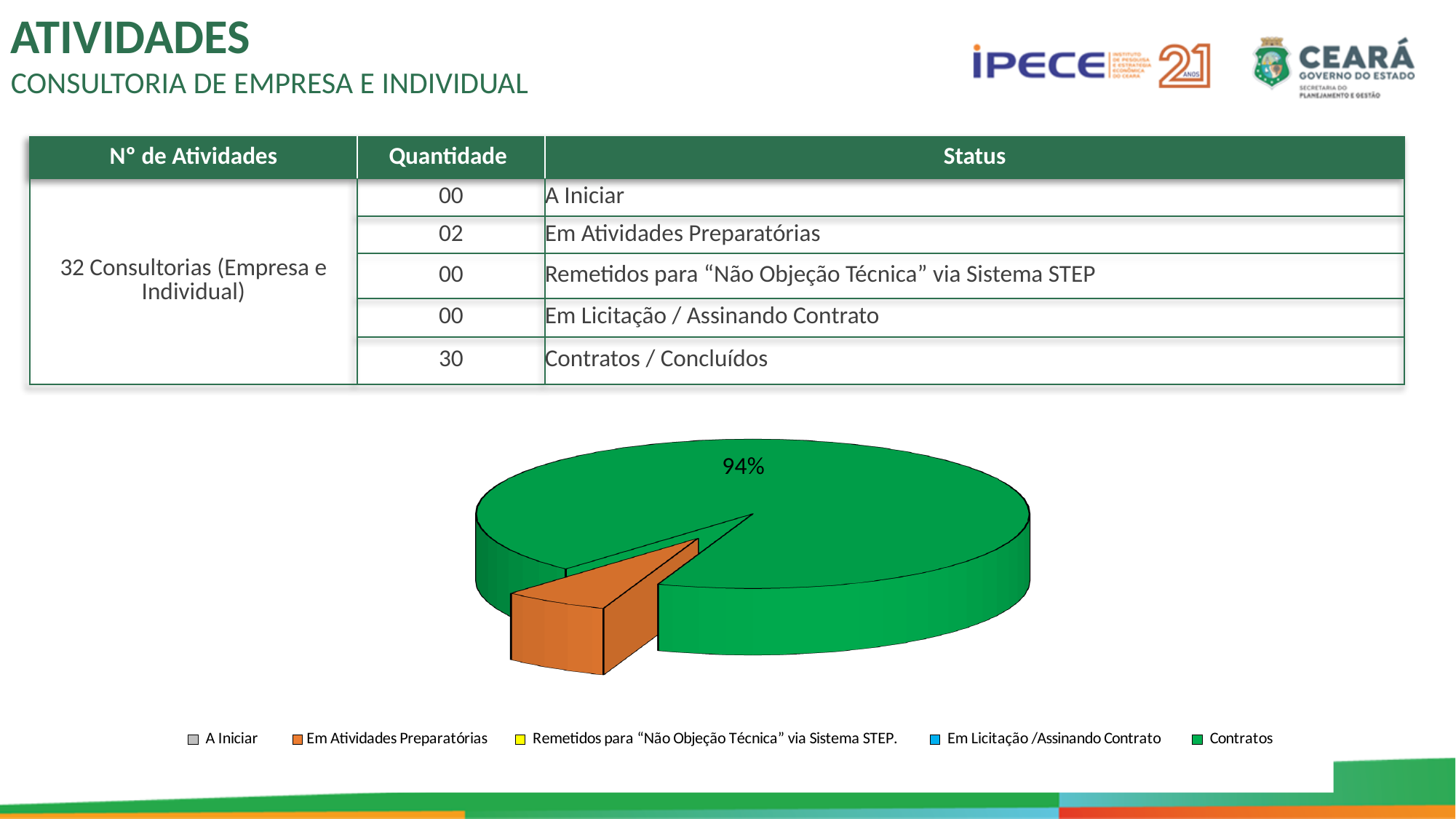
Is the share for Contratos greater or less than 50%? greater Which slice is larger, Contratos or Em Atividades Preparatórias? Contratos What percentage is printed on the Contratos slice of the pie chart? 94% Which legend category corresponds to the small pulled-out slice of the pie? Em Atividades Preparatórias What colour does the legend assign to Em Atividades Preparatórias? orange How many slices are visibly drawn in the pie chart? 2 What kind of chart is shown on the slide? pie chart What colour is the Contratos slice in the pie chart? green What share of the pie does the Contratos slice represent? 94% How many entries does the chart legend list? 5 Which category has the largest slice in the pie chart? Contratos